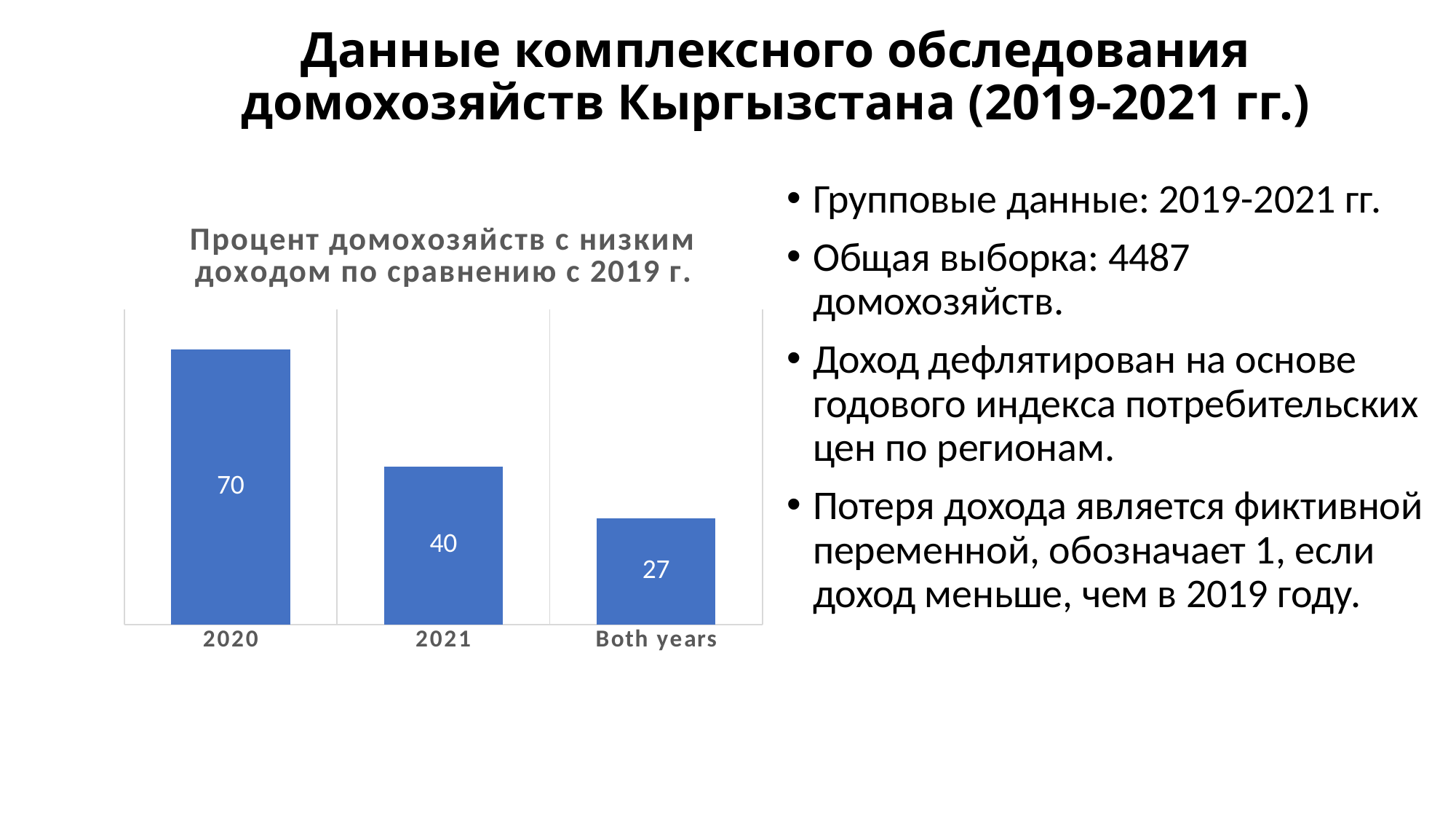
Which is larger, the value for 2021 or the value for Both years? 2021 Do the values rise or fall from left to right across the categories? Fall What kind of chart is shown on the slide? Bar chart What is the title of the chart? Процент домохозяйств с низким доходом по сравнению с 2019 г. What is the value for Both years? 27 What is the difference between the values for 2020 and 2021? 30 What is the value for 2021? 40 Which category has the highest value? 2020 What is the difference between the values for 2021 and Both years? 13 How many categories are shown in the chart? 3 What is the value for 2020? 70 Which category has the lowest value? Both years